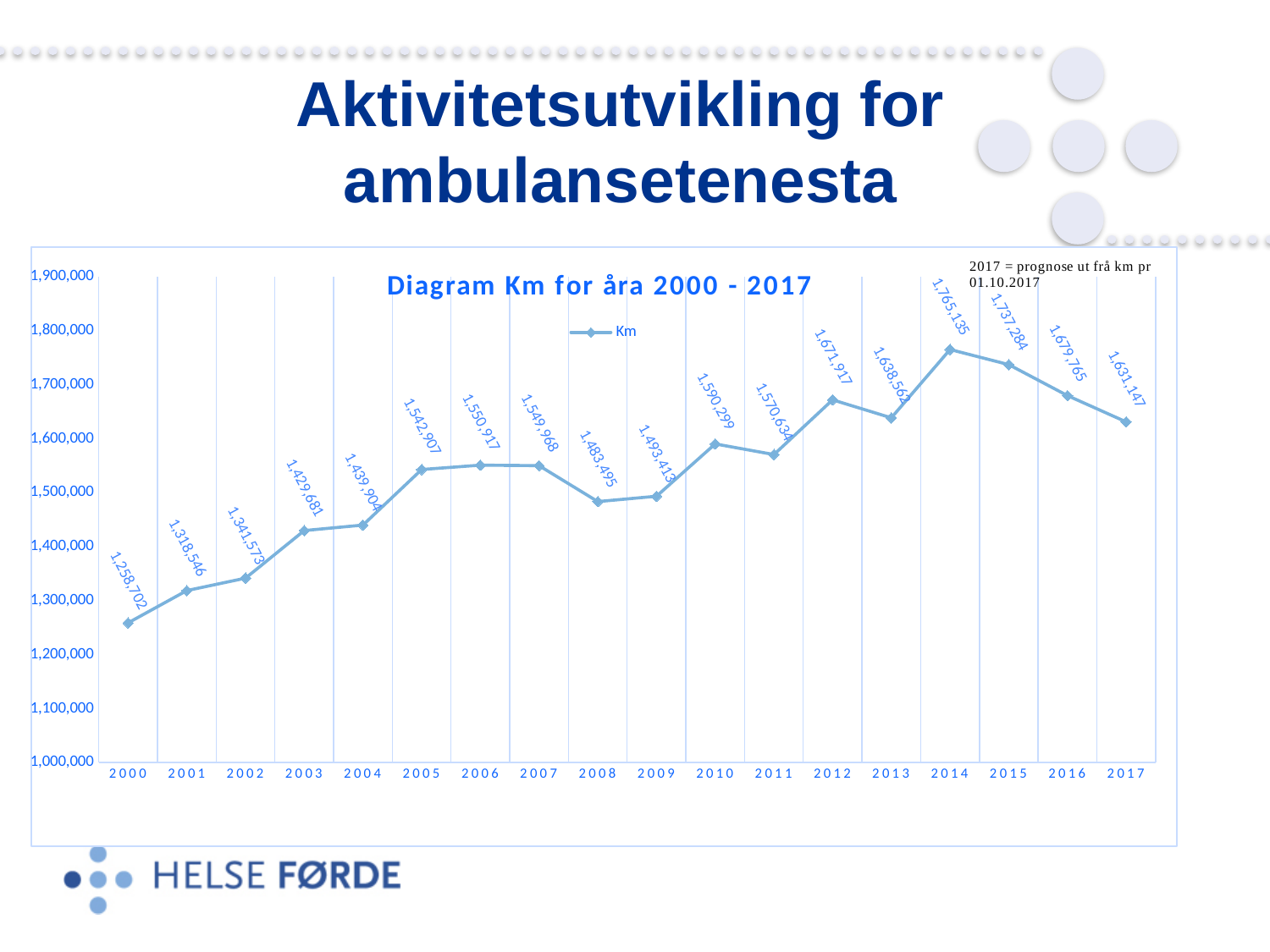
Is the Km value for 2008 greater or less than 1,500,000? less What is the difference between the Km values for 2016 and 2017? 48,618 How many years are plotted on the chart? 18 Which year has the lowest Km value? 2000 Which year has the larger Km value, 2012 or 2013? 2012 What is the Km value for 2017? 1,631,147 What is the Km value for 2014? 1,765,135 Which year has the highest Km value? 2014 What is the Km value for 2000? 1,258,702 What kind of chart is shown on the slide? line chart Do the Km values rise or fall from 2014 to 2017? fall What is the difference between the Km values for 2014 and 2000? 506,433